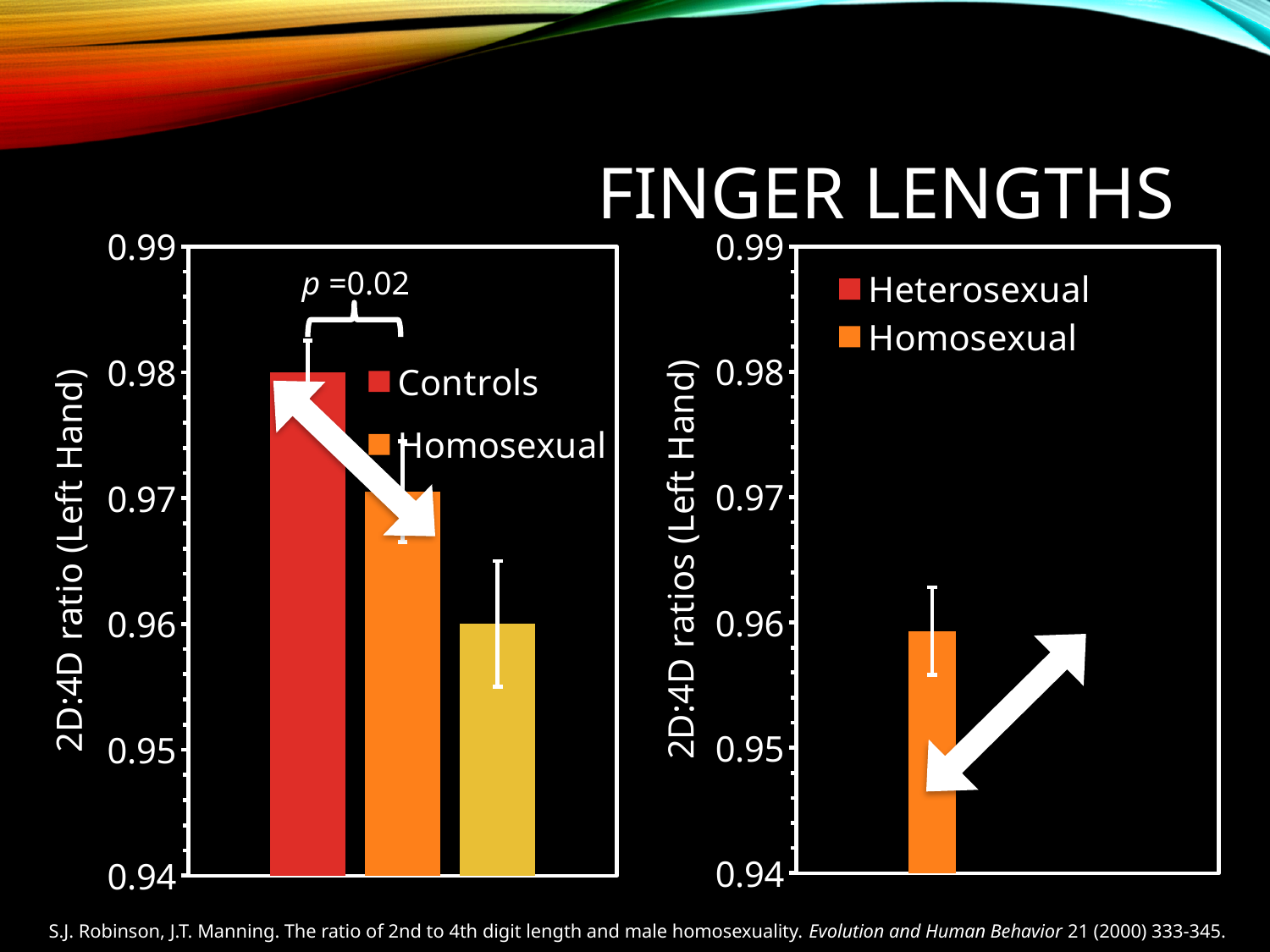
In the left chart, how many series does the legend list? 2 In the right chart, is the value for Homosexual greater or less than 0.97? less In the left chart, is the value for Controls greater or less than 0.97? greater What p value is printed on the left chart? p = 0.02 In the left chart, how many bars are plotted? 3 In the left chart, is the value for Homosexual greater or less than 0.96? greater What kind of chart is the left chart on the slide? bar chart In the left chart, which legend series has the highest bar? Controls In the left chart, which is larger, the Controls bar or the Homosexual bar? Controls In the right chart, how many series does the legend list? 2